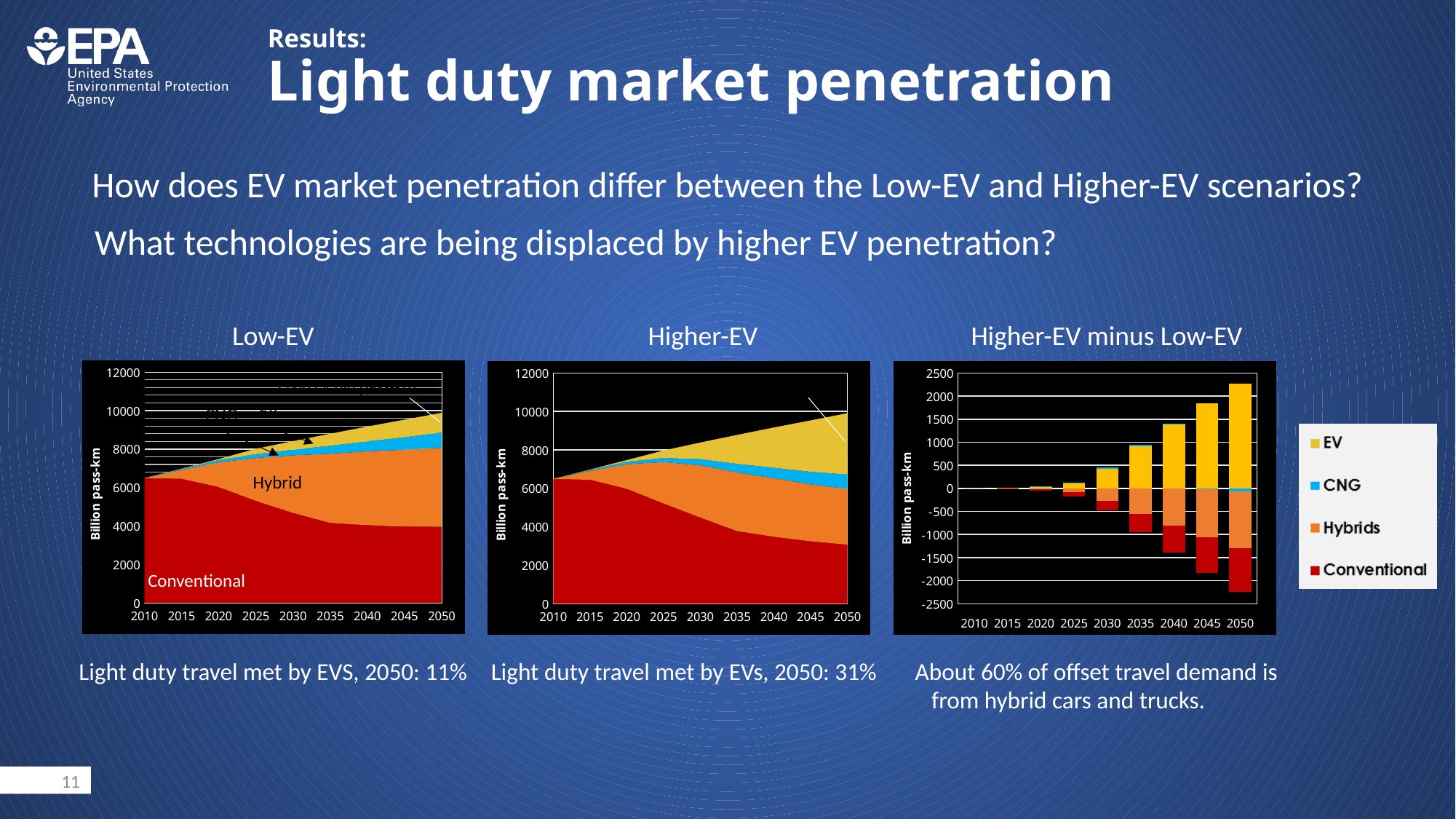
What is the y-axis label on the 'Low-EV' chart? Billion pass-km In the 'Higher-EV' chart, is the Conventional value in 2050 greater or less than 4000? less In the 'Higher-EV minus Low-EV' chart, is the EV value for 2050 greater or less than 2000? greater In the 'Higher-EV minus Low-EV' chart, do the EV bars rise or fall from 2010 to 2050? rise How many years are labelled on the x axis of the 'Higher-EV' chart? 9 In the 'Low-EV' chart, is the Conventional value in 2010 greater or less than 6000? greater In the 'Higher-EV minus Low-EV' chart, is the EV bar larger in 2045 or in 2050? 2050 In the 'Higher-EV minus Low-EV' chart, in which year is the EV bar highest? 2050 What kind of chart is the 'Higher-EV minus Low-EV' chart? bar chart What kind of chart is the 'Low-EV' chart? area chart How many series does the legend list for the 'Higher-EV minus Low-EV' chart? 4